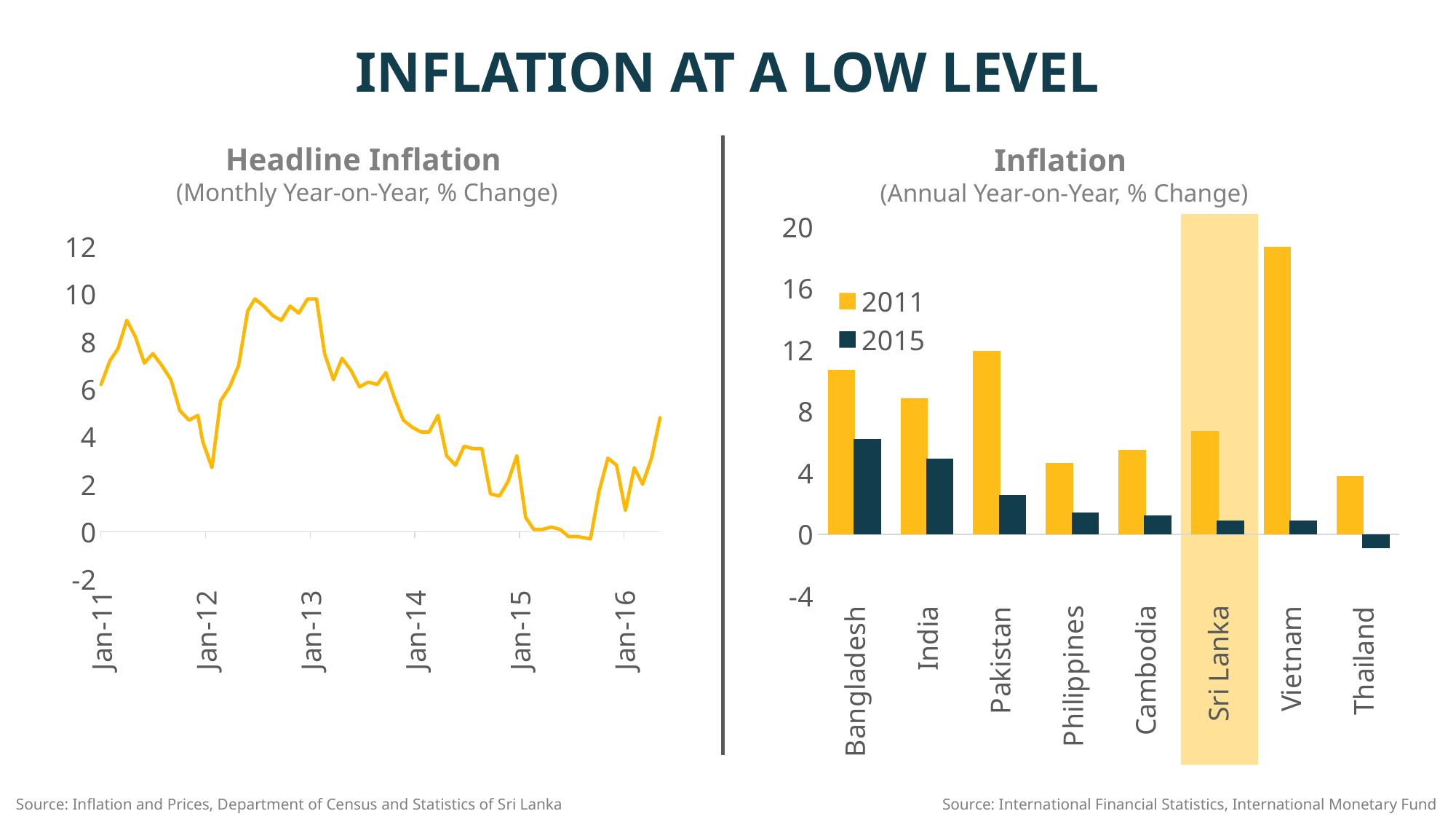
In the Inflation (Annual Year-on-Year, % Change) chart, is the 2015 value for Thailand greater or less than 0? less In the Inflation (Annual Year-on-Year, % Change) chart, which country has the highest 2011 value? Vietnam In the Inflation (Annual Year-on-Year, % Change) chart, how many countries are shown on the x axis? 8 In the Inflation (Annual Year-on-Year, % Change) chart, which is larger for Pakistan: the 2011 value or the 2015 value? 2011 In the Headline Inflation chart, does the line rise or fall between Jan-13 and Jan-15? fall In the Inflation (Annual Year-on-Year, % Change) chart, which country is highlighted with a shaded band? Sri Lanka What kind of chart is the Inflation (Annual Year-on-Year, % Change) chart on the right? bar chart In the Inflation (Annual Year-on-Year, % Change) chart, which country has the lowest 2015 value? Thailand In the Inflation (Annual Year-on-Year, % Change) chart, which country has the highest 2015 value? Bangladesh In the Inflation (Annual Year-on-Year, % Change) chart, how many series does the legend list? 2 In the Inflation (Annual Year-on-Year, % Change) chart, is the 2011 value for Vietnam greater or less than 16? greater What kind of chart is the Headline Inflation chart on the left? line chart